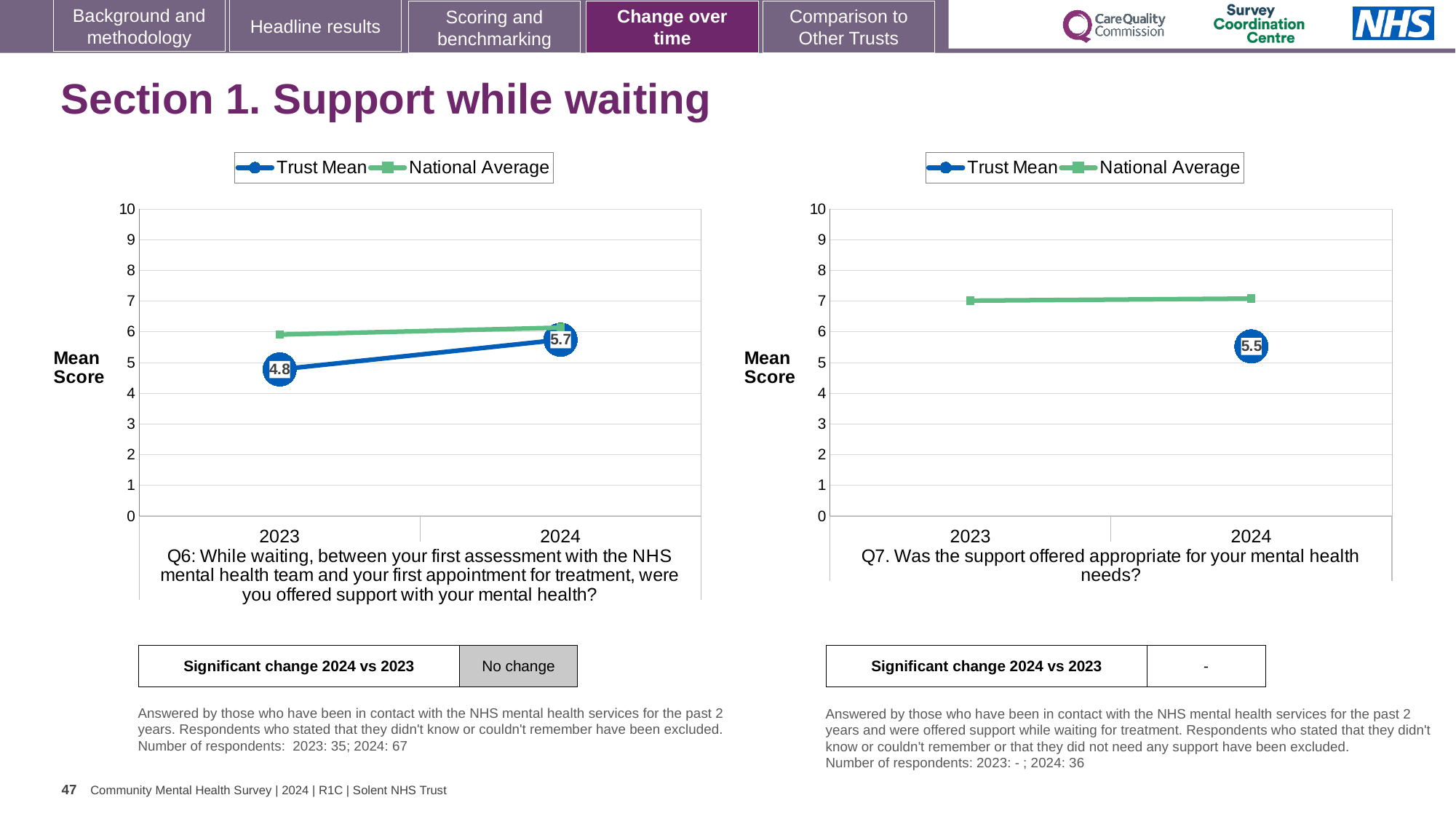
In the right chart (Q7), what is the Trust Mean score for 2024? 5.5 In the left chart (Q6), what is the Trust Mean score for 2023? 4.8 How many years are shown on the x axis of the left chart (Q6)? 2 How many series does the legend of the right chart (Q7) list? 2 In the left chart (Q6), by how much did the Trust Mean change from 2023 to 2024? 0.9 In the right chart (Q7), is the National Average for 2024 greater or less than 6? greater In the left chart (Q6), what is the Trust Mean score for 2024? 5.7 In the left chart (Q6), is the National Average for 2023 greater or less than 5? greater In the left chart (Q6), which is higher in 2023: the Trust Mean or the National Average? National Average In the right chart (Q7), which is higher in 2024: the Trust Mean or the National Average? National Average What type of chart is used on the left of the slide (Q6)? line chart In the left chart (Q6), does the Trust Mean rise or fall from 2023 to 2024? rise